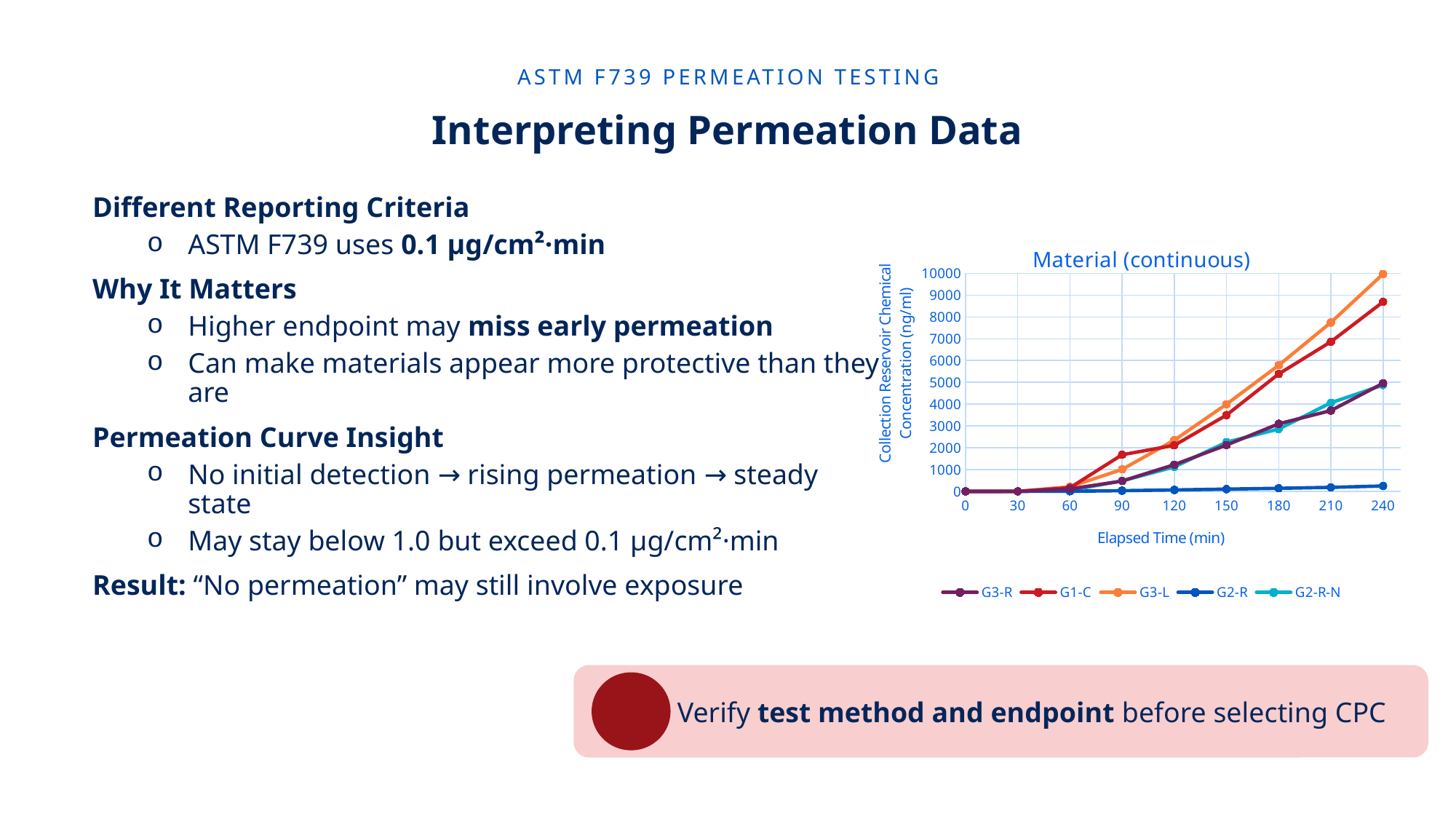
Which series has the lowest value at 240 minutes? G2-R Is the value for G1-C at 240 minutes greater or less than 8000? greater How many series does the chart legend list? 5 What is the title of the chart? Material (continuous) Is the value for G3-R at 240 minutes greater or less than 4000? greater At 90 minutes, which series has the larger value, G1-C or G3-L? G1-C What kind of chart is shown on the slide? line chart Is the value for G3-L at 240 minutes greater or less than 9000? greater How many time points are marked along the x axis of the chart? 9 Which series has the highest value at 240 minutes? G3-L Does the G3-L series rise or fall as elapsed time increases? rises